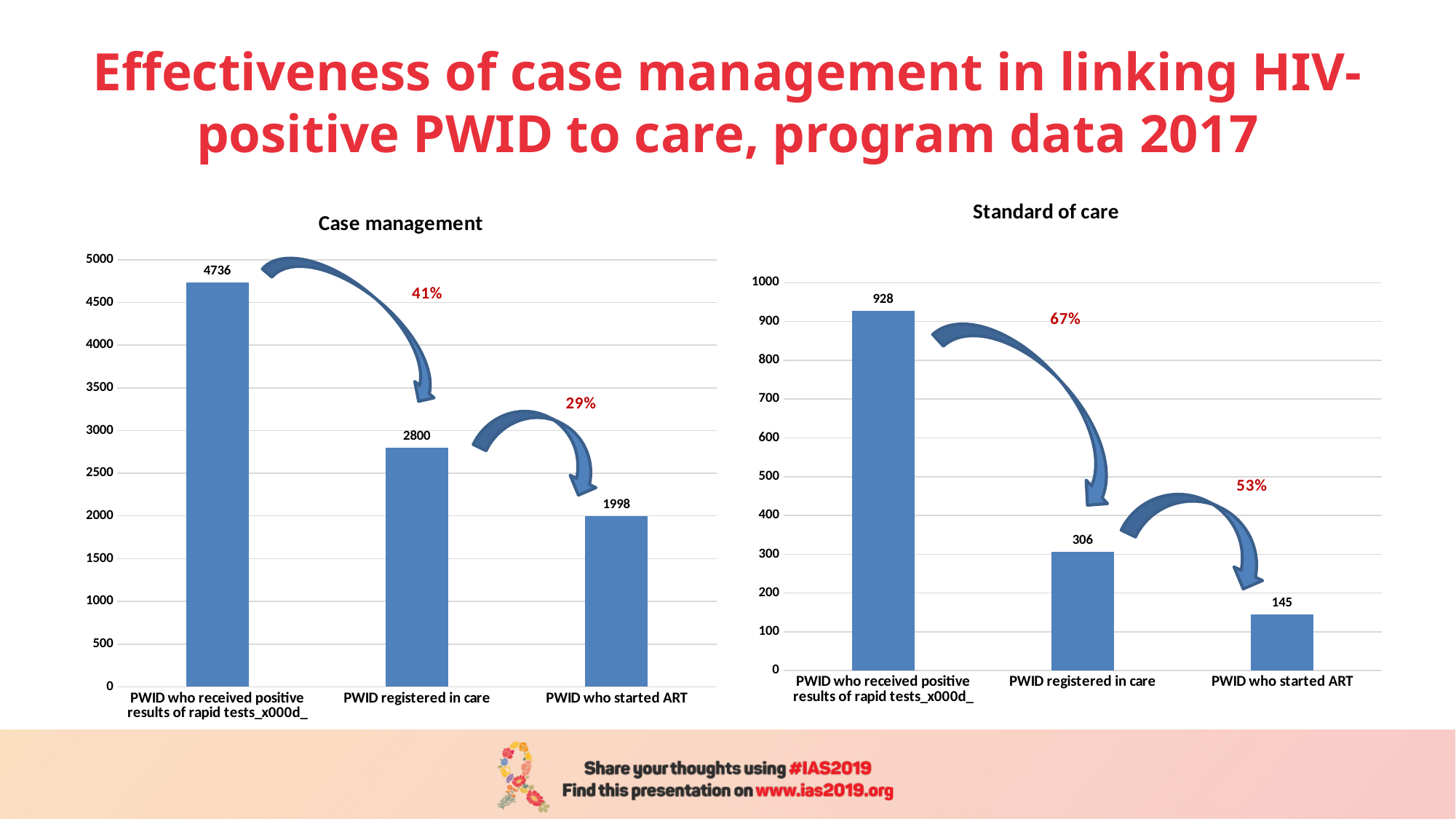
In the 'Case management' chart, what is the value for PWID registered in care? 2800 In the 'Standard of care' chart, which category has the highest value? PWID who received positive results of rapid tests What type of chart is the 'Case management' chart? Bar chart In the 'Standard of care' chart, what is the value for PWID who started ART? 145 In the 'Standard of care' chart, what is the difference between PWID who received positive results of rapid tests and PWID registered in care? 622 In the 'Case management' chart, what is the difference between PWID registered in care and PWID who started ART? 802 Which is larger: PWID who started ART in the 'Case management' chart or PWID who received positive results of rapid tests in the 'Standard of care' chart? PWID who started ART in the Case management chart In the 'Standard of care' chart, what is the value for PWID registered in care? 306 In the 'Case management' chart, which category has the lowest value? PWID who started ART How many categories are shown in the 'Standard of care' chart? 3 In the 'Case management' chart, what is the value for PWID who received positive results of rapid tests? 4736 In the 'Standard of care' chart, do the values rise or fall from left to right? Fall